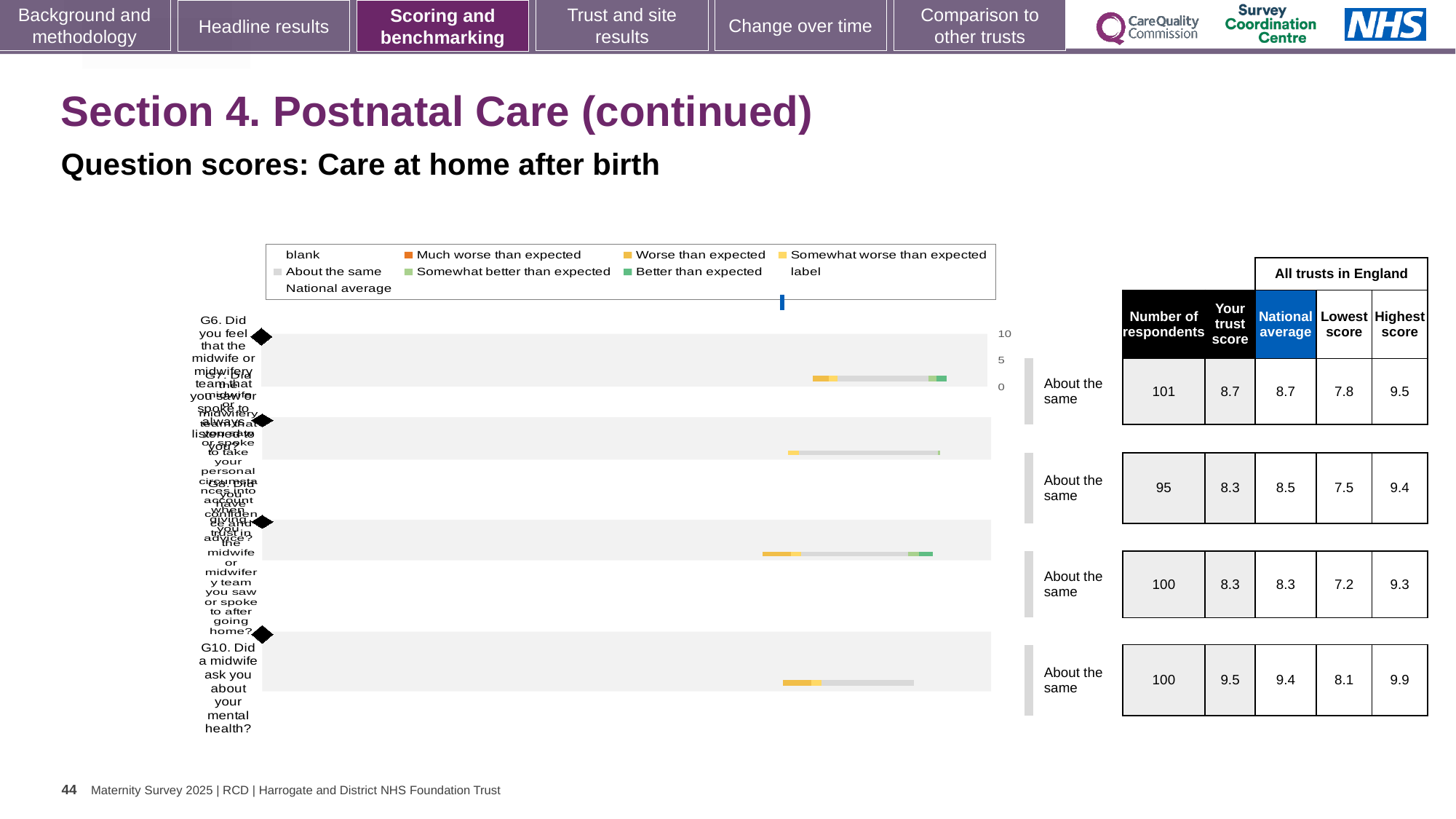
What is the highest score among all trusts in England for G10 (Did a midwife ask you about your mental health?)? 9.9 What is the difference between the highest and lowest scores for G6 (Did you feel that the midwife or midwifery team listened to you?)? 1.7 What is the lowest score among all trusts in England for G6 (Did you feel that the midwife or midwifery team listened to you?)? 7.8 What is the national average for G6 (Did you feel that the midwife or midwifery team listened to you?)? 8.7 Which question has the highest trust score in the table? G10. Did a midwife ask you about your mental health? What benchmark category is shown for G6 (Did you feel that the midwife or midwifery team listened to you?)? About the same What type of chart is shown on the slide? bar chart What is the trust score for G10 (Did a midwife ask you about your mental health?)? 9.5 Is the trust score for G10 (Did a midwife ask you about your mental health?) higher or lower than the national average? higher How many questions are plotted in the chart? 4 How many respondents answered G10 (Did a midwife ask you about your mental health?)? 100 What is the difference between the trust score and the national average for G10 (Did a midwife ask you about your mental health?)? 0.1